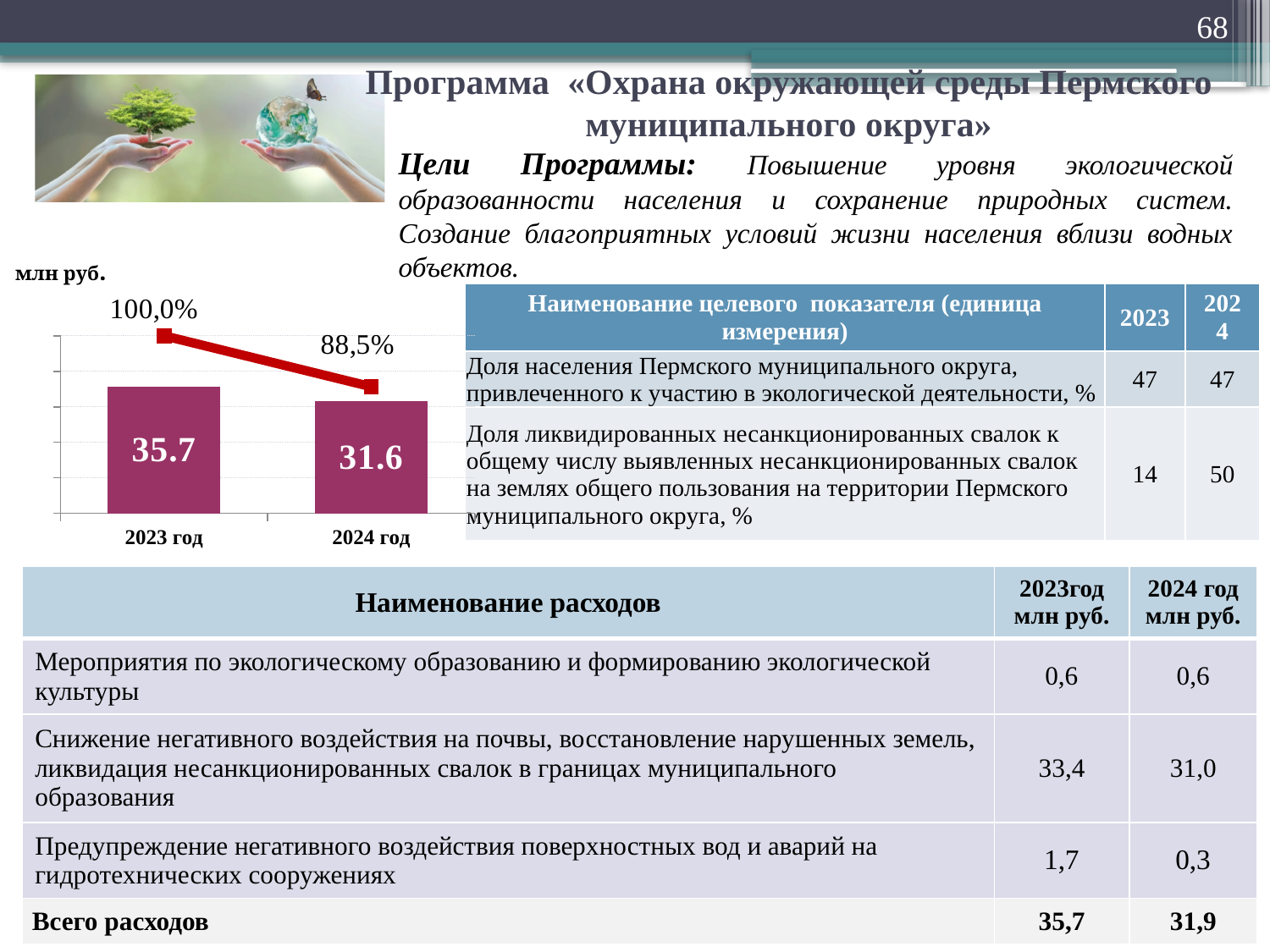
Which category has the highest bar in the chart? 2023 год What kind of chart is shown on the slide? bar chart with a line Do the bar values rise or fall from 2023 год to 2024 год in the chart? fall Which year has the higher bar in the chart, 2023 год or 2024 год? 2023 год What unit is indicated above the chart? млн руб. Which category has the lowest bar in the chart? 2024 год What is the value of the bar for 2023 год in the chart? 35.7 What is the value of the bar for 2024 год in the chart? 31.6 How many categories are shown on the x axis of the chart? 2 What percentage label is shown on the line for 2024 год in the chart? 88,5% What percentage label is shown on the line for 2023 год in the chart? 100,0% What is the difference between the bar values for 2023 год and 2024 год in the chart? 4.1